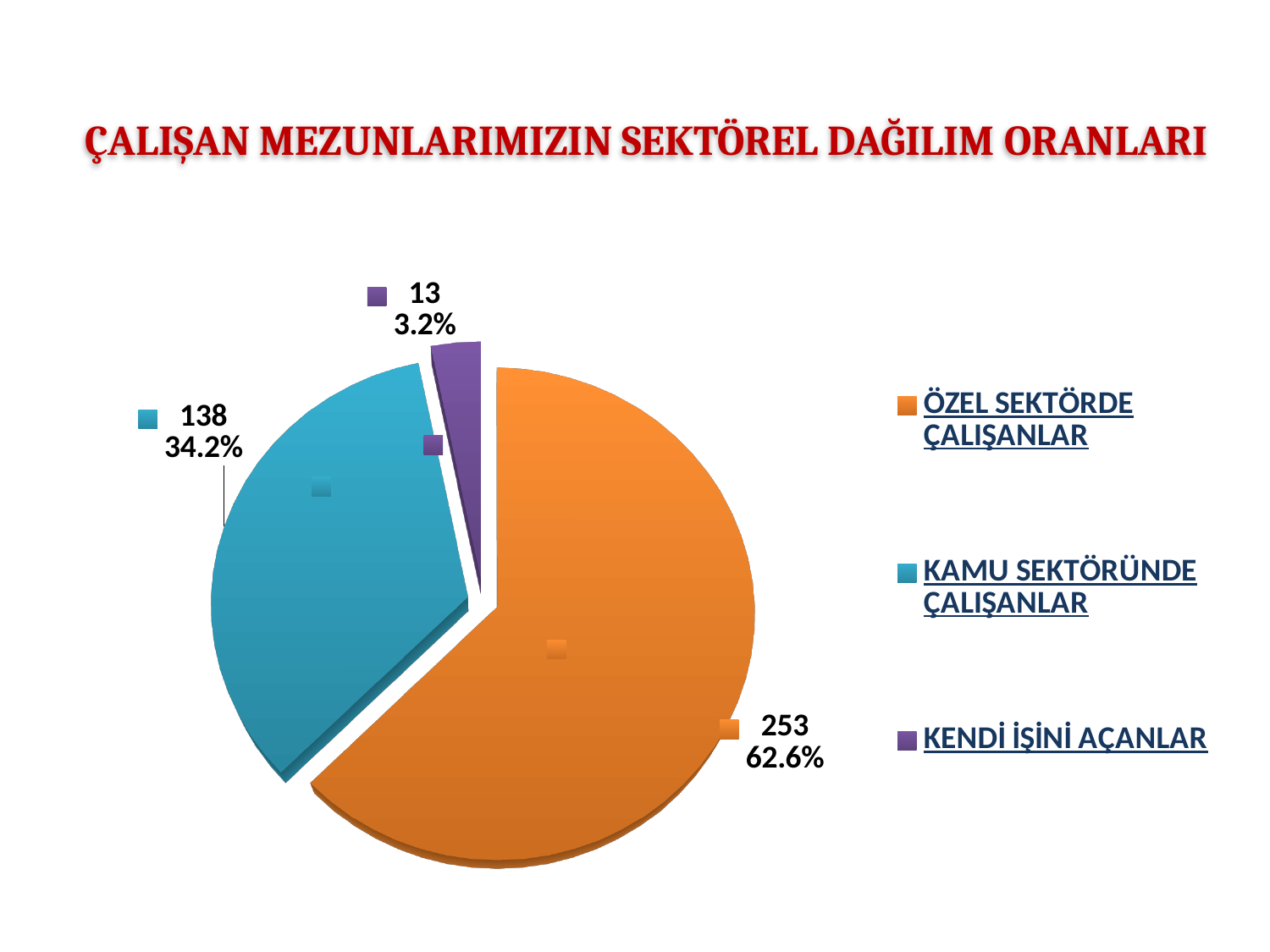
What share of the pie does KAMU SEKTÖRÜNDE ÇALIŞANLAR represent? 34.2% How many categories does the pie chart have? 3 What is the value for KAMU SEKTÖRÜNDE ÇALIŞANLAR? 138 Which category has the largest slice? ÖZEL SEKTÖRDE ÇALIŞANLAR What is the title of the chart? ÇALIŞAN MEZUNLARIMIZIN SEKTÖREL DAĞILIM ORANLARI What share of the pie does KENDİ İŞİNİ AÇANLAR represent? 3.2% What is the value for KENDİ İŞİNİ AÇANLAR? 13 What is the value for ÖZEL SEKTÖRDE ÇALIŞANLAR? 253 What is the difference between the values for ÖZEL SEKTÖRDE ÇALIŞANLAR and KAMU SEKTÖRÜNDE ÇALIŞANLAR? 115 Which category has the smallest slice? KENDİ İŞİNİ AÇANLAR What kind of chart is shown on the slide? Pie chart What share of the pie does ÖZEL SEKTÖRDE ÇALIŞANLAR represent? 62.6%